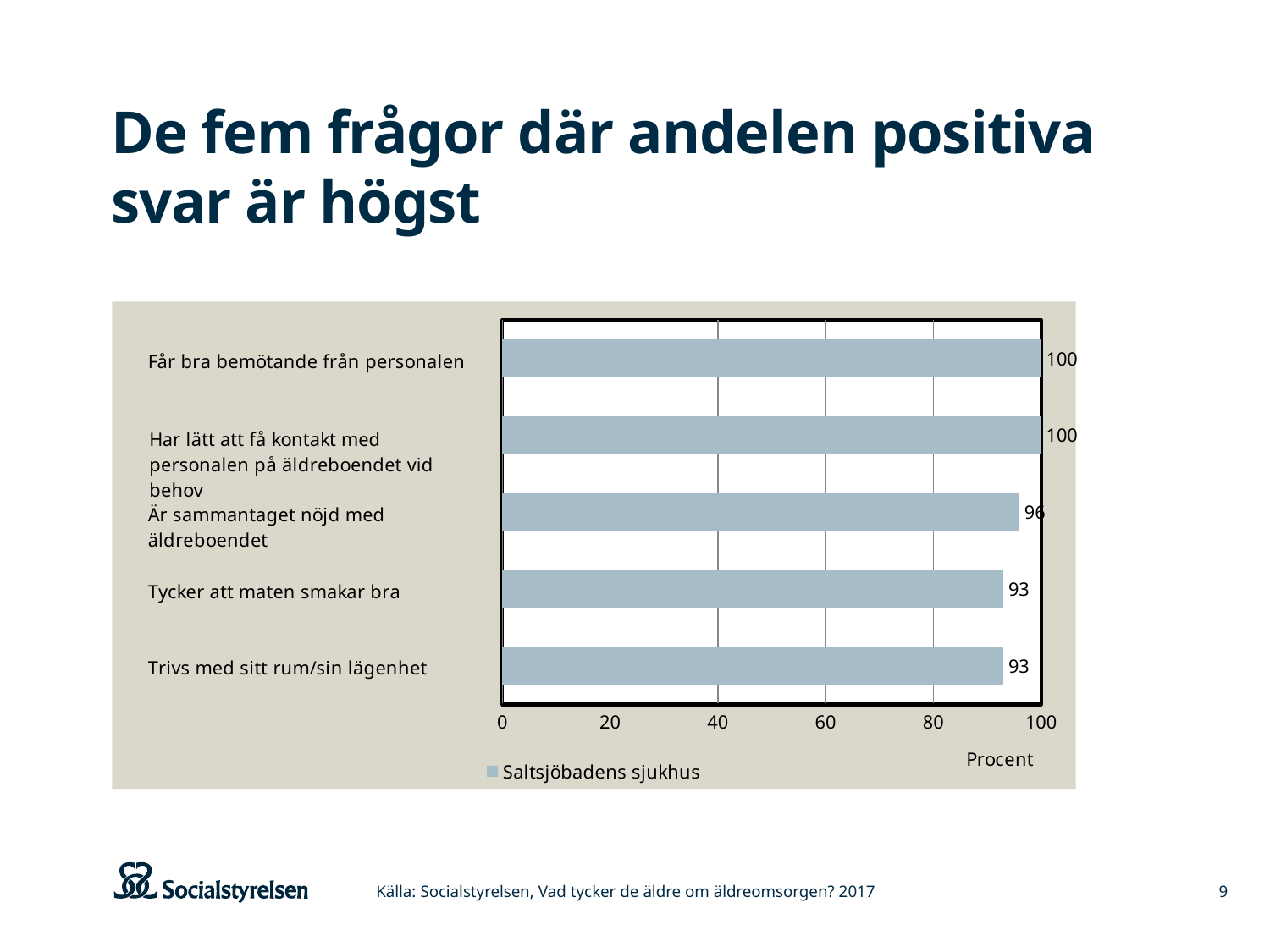
What is the difference between the values for "Är sammantaget nöjd med äldreboendet" and "Tycker att maten smakar bra"? 3 How many series does the legend list? 1 What kind of chart is shown on the slide? bar chart What is the value for "Trivs med sitt rum/sin lägenhet"? 93 Which has a larger value: "Är sammantaget nöjd med äldreboendet" or "Tycker att maten smakar bra"? Är sammantaget nöjd med äldreboendet How many categories are shown in the chart? 5 What is the value for "Tycker att maten smakar bra"? 93 What is the difference between the values for "Har lätt att få kontakt med personalen på äldreboendet vid behov" and "Är sammantaget nöjd med äldreboendet"? 4 Is the value for "Trivs med sitt rum/sin lägenhet" greater or less than 80? greater What is the value for "Är sammantaget nöjd med äldreboendet"? 96 What is the lowest value shown in the chart? 93 What is the value for "Får bra bemötande från personalen"? 100